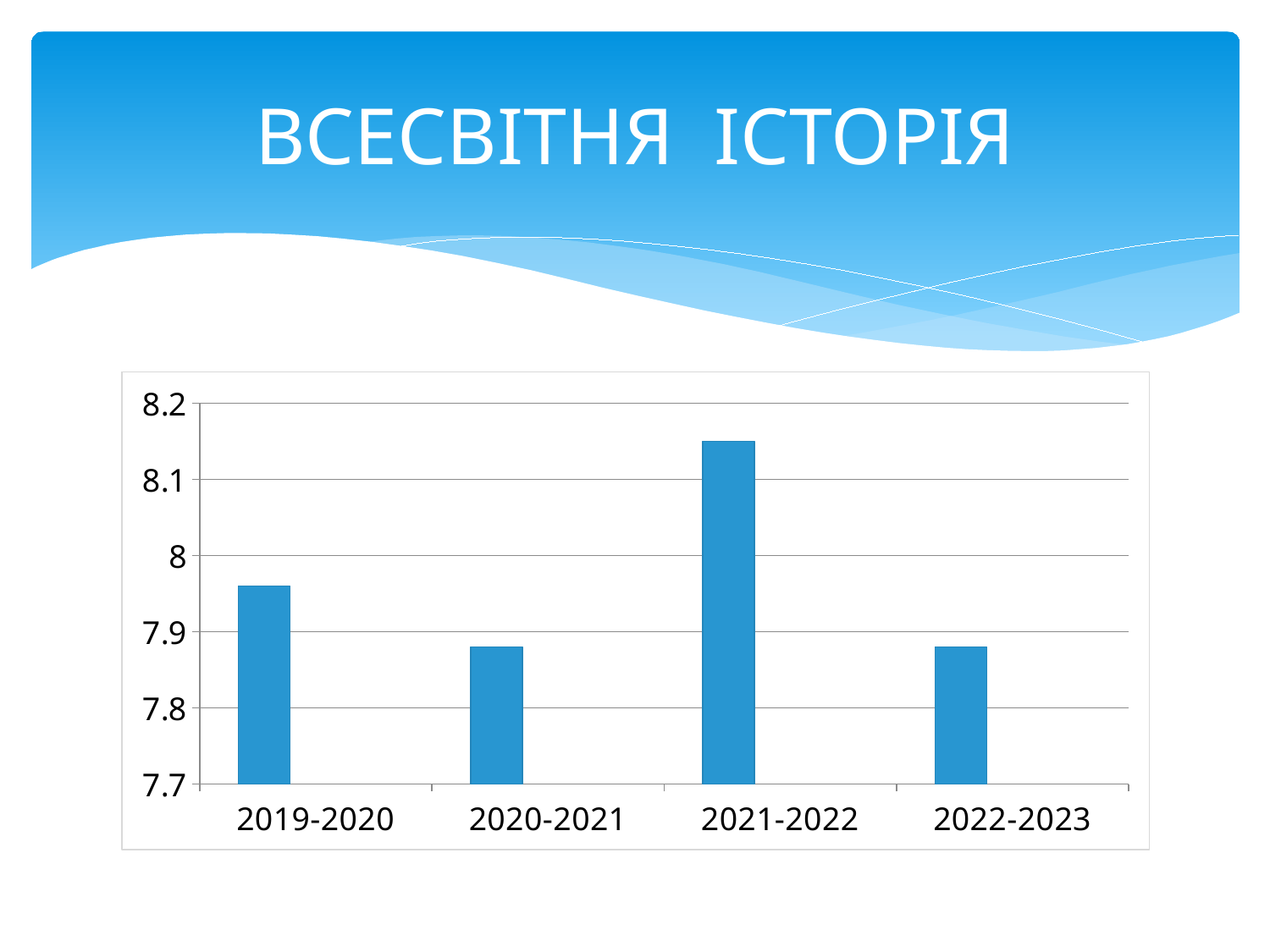
What kind of chart is shown on the slide? bar chart Is the value for 2019-2020 greater or less than 8? less How many categories (school years) are shown on the x axis? 4 Does the value rise or fall from 2021-2022 to 2022-2023? fall Which is larger, the value for 2019-2020 or the value for 2020-2021? 2019-2020 Which school year has the highest value? 2021-2022 Which is larger, the value for 2021-2022 or the value for 2022-2023? 2021-2022 What is the title of the slide above the chart? ВСЕСВІТНЯ ІСТОРІЯ Is the value for 2019-2020 greater or less than 7.9? greater Is the value for 2021-2022 greater or less than 8.1? greater